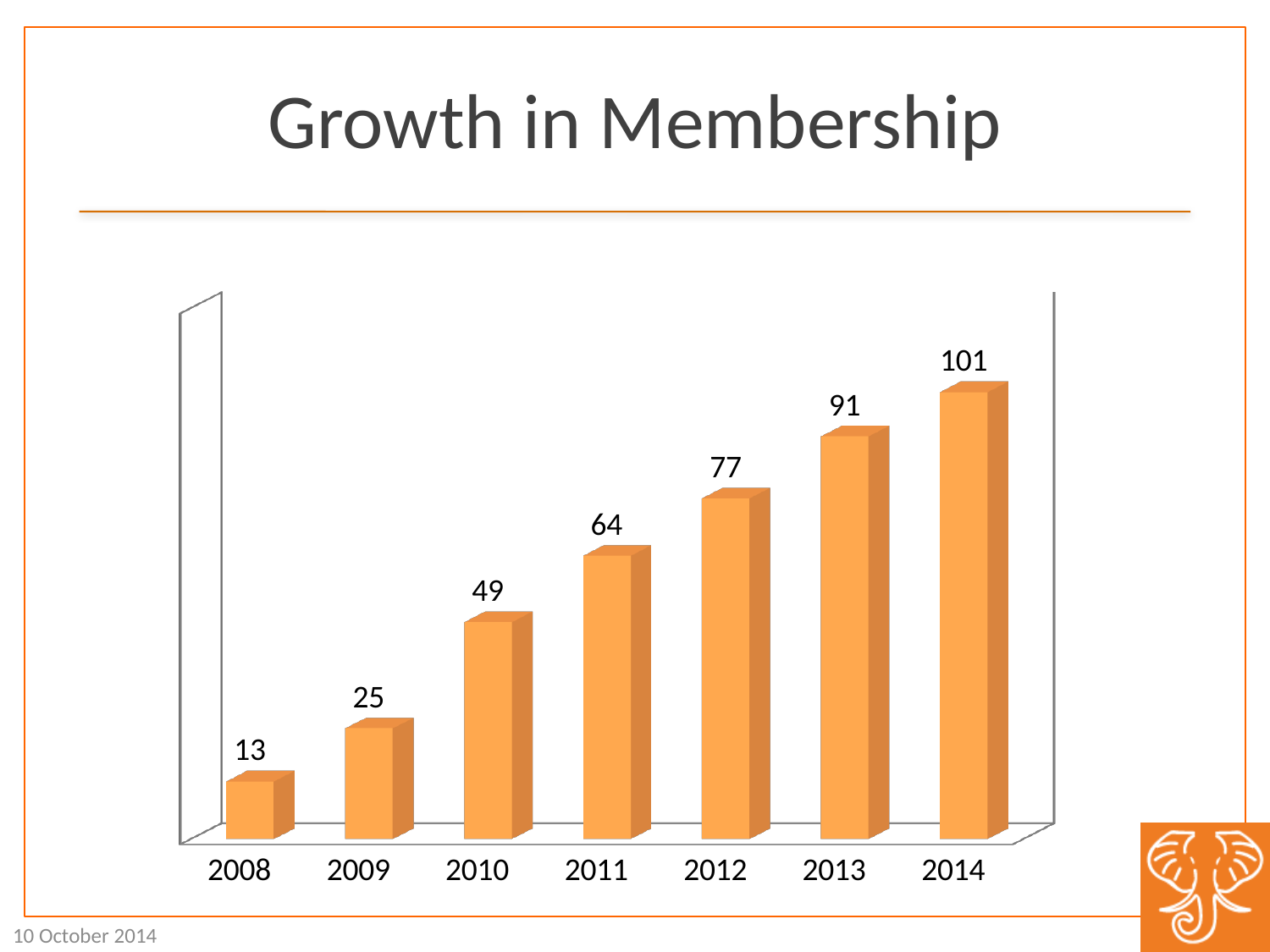
What is the membership value shown for 2010? 49 What is the membership value shown for 2008? 13 What is the membership value shown for 2013? 91 Which year has the highest membership value? 2014 What is the title of the chart on the slide? Growth in Membership Do the membership values rise or fall from 2008 to 2014? Rise Which year has the lowest membership value? 2008 Which is larger, the value for 2011 or the value for 2012? 2012 What kind of chart is shown on the slide? Bar chart What is the difference between the membership values for 2010 and 2009? 24 How many years are shown on the x axis of the chart? 7 What is the difference between the membership values for 2014 and 2013? 10